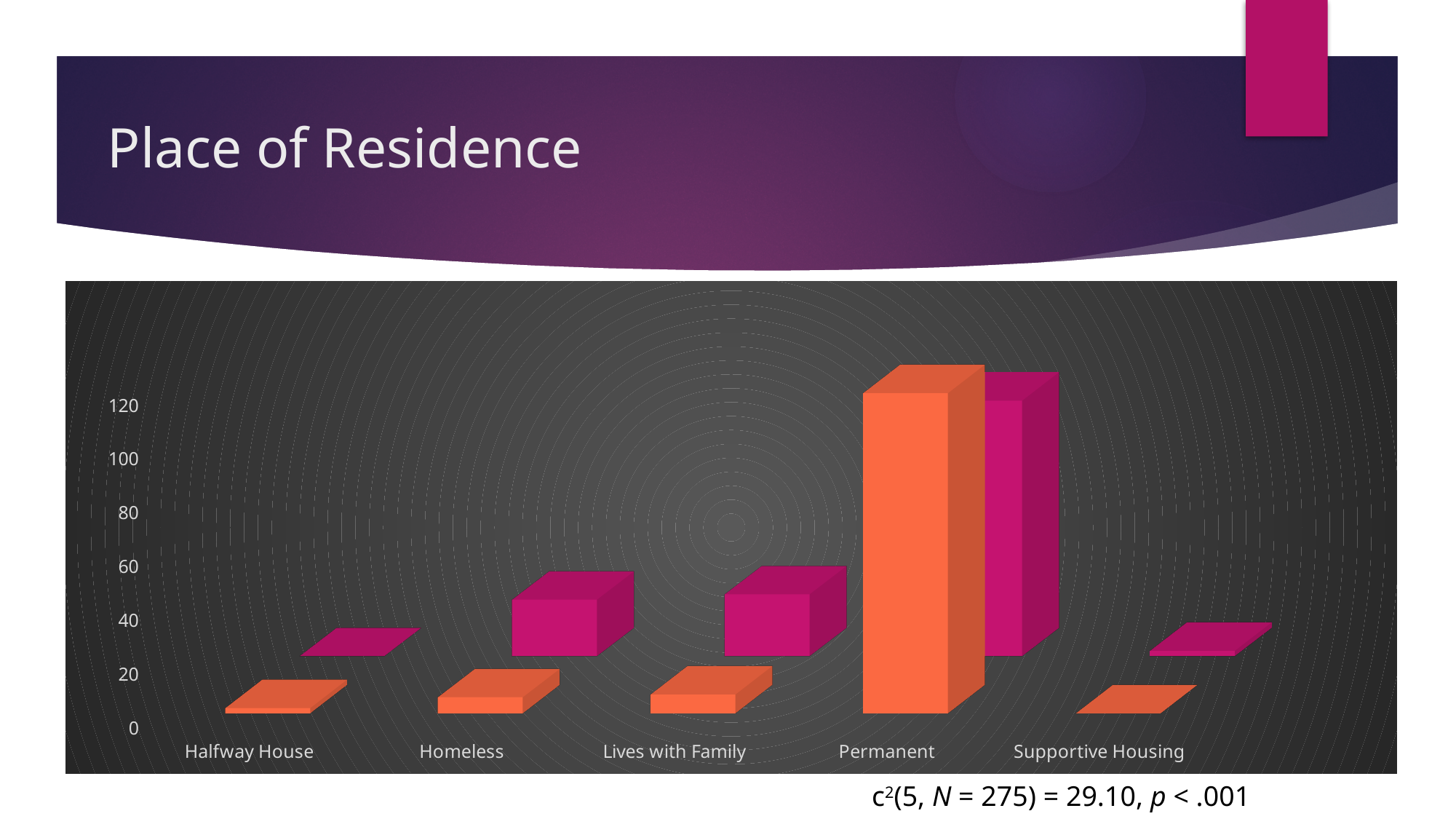
Is the orange bar for Permanent greater or less than 100? greater Which category has the tallest orange bar? Permanent Is the orange bar for Halfway House greater or less than 20? less What sample size N is reported in the statistic below the chart? 275 What kind of chart is shown on the slide? bar chart Is the magenta bar for Permanent greater or less than 60? greater Which is larger, the magenta bar for Homeless or the magenta bar for Halfway House? Homeless Which category has the tallest magenta bar? Permanent How many categories are shown on the x axis of the chart? 5 Which is larger, the orange bar for Permanent or the orange bar for Homeless? Permanent What is the title of the slide containing the chart? Place of Residence